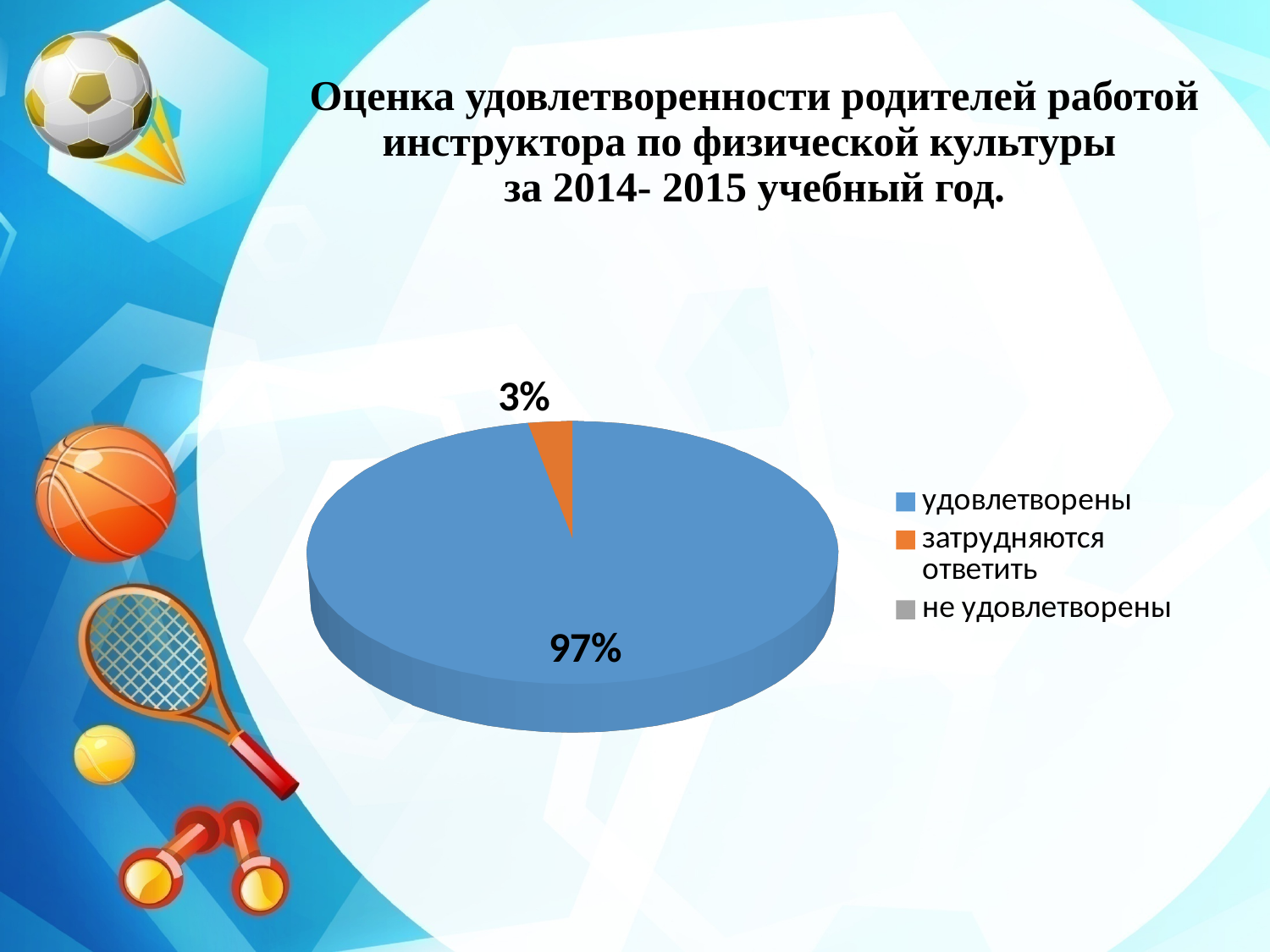
What is the difference in percentage points between the "удовлетворены" slice and the "затрудняются ответить" slice? 94 How many entries does the legend list? 3 What kind of chart is shown on the slide? pie chart What colour is the "затрудняются ответить" slice? orange Which category has the largest slice of the pie? удовлетворены Is the share for "удовлетворены" greater or less than 50%? greater How many slices have a percentage label printed on the chart? 2 Which is larger: the "удовлетворены" slice or the "затрудняются ответить" slice? удовлетворены What share of the pie is labelled "удовлетворены"? 97% What share of the pie is labelled "затрудняются ответить"? 3% What colour is the "удовлетворены" slice? blue Which of the visible slices is the smallest? затрудняются ответить